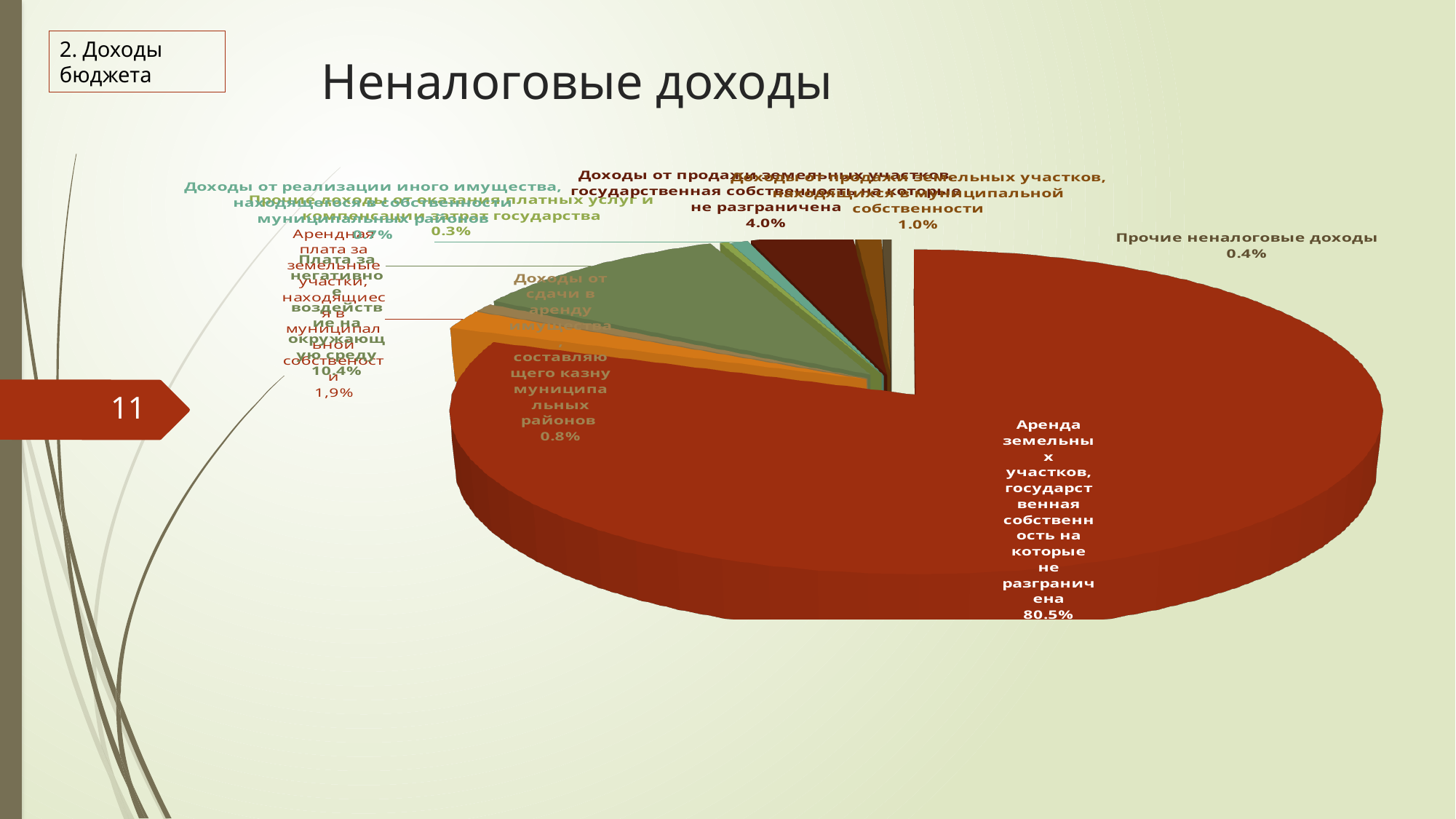
Which is larger: the share of 'Прочие неналоговые доходы' or 'Доходы от сдачи в аренду имущества, составляющего казну муниципальных районов'? Доходы от сдачи в аренду имущества, составляющего казну муниципальных районов What share of the pie is 'Прочие неналоговые доходы'? 0.4% Is the share of 'Аренда земельных участков, государственная собственность на которые не разграничена' greater or less than 50%? greater What share of the pie is 'Доходы от продажи земельных участков, государственная собственность на которые не разграничена'? 4.0% What is the difference in percentage points between 'Доходы от продажи земельных участков, государственная собственность на которые не разграничена' (4.0%) and 'Доходы от продажи земельных участков, находящихся в муниципальной собственности' (1.0%)? 3.0 percentage points What share of the pie is 'Доходы от сдачи в аренду имущества, составляющего казну муниципальных районов'? 0.8% What type of chart is shown on the slide? Pie chart Which category has the largest share of the pie? Аренда земельных участков, государственная собственность на которые не разграничена Which is larger: the share of 'Доходы от продажи земельных участков, государственная собственность на которые не разграничена' or 'Доходы от продажи земельных участков, находящихся в муниципальной собственности'? Доходы от продажи земельных участков, государственная собственность на которые не разграничена What is the title of the chart? Неналоговые доходы